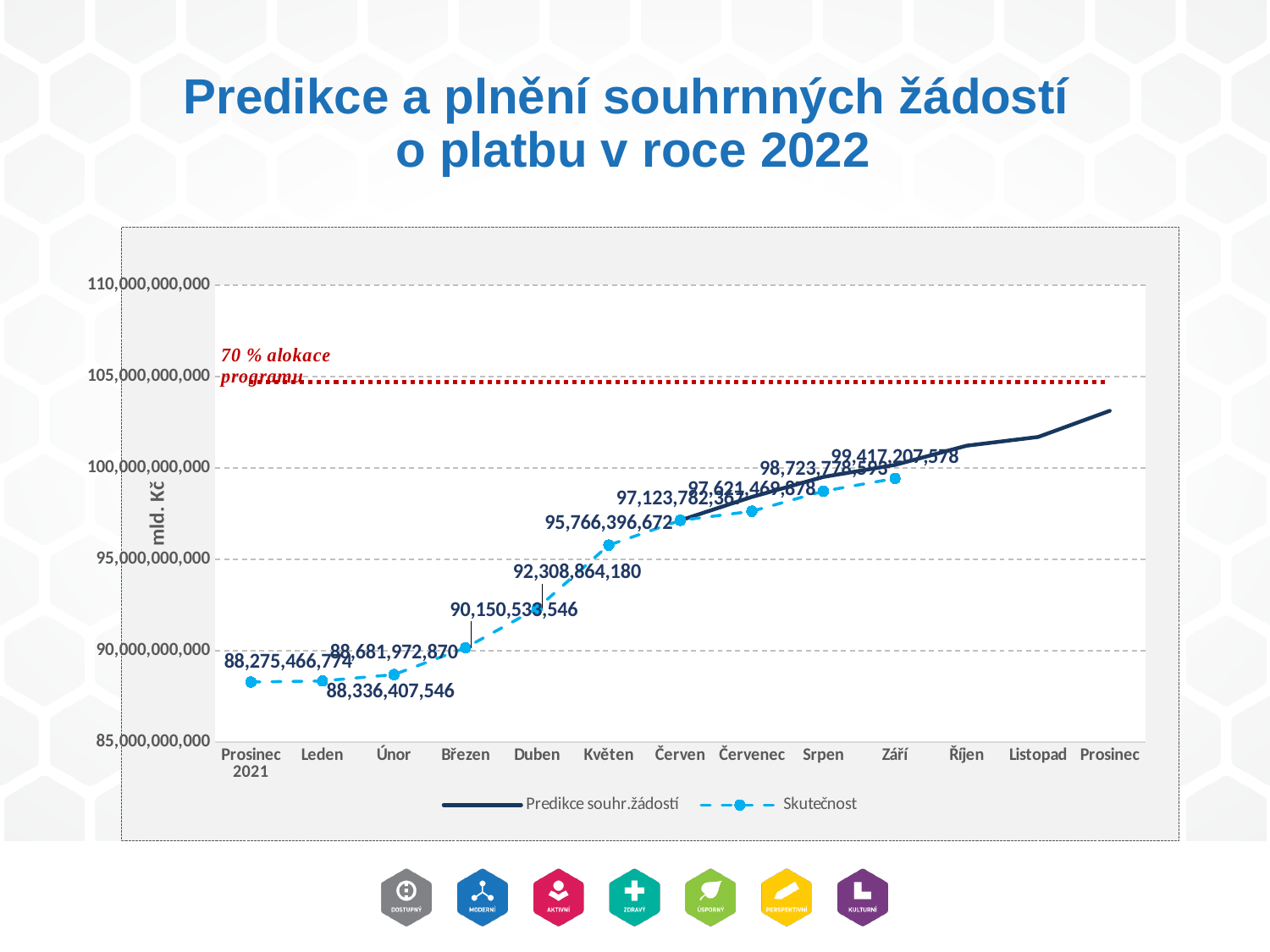
What is the Skutečnost value for Květen? 95,766,396,672 How many series does the chart legend list? 2 What kind of chart is shown on the slide? line chart What is the difference between the Skutečnost values for Květen and Duben? 3,457,532,492 Is the Skutečnost value for Září greater or less than 100,000,000,000? less What is the Skutečnost value for Leden? 88,336,407,546 What is the Skutečnost value for Prosinec 2021? 88,275,466,774 How many categories are shown on the x axis of the chart? 13 Is the Predikce souhr.žádostí value for Prosinec greater or less than 100,000,000,000? greater What label is written next to the red dotted horizontal line on the chart? 70 % alokace programu What is the Skutečnost value for Duben? 92,308,864,180 Do the Skutečnost values rise or fall from Prosinec 2021 to Září? rise